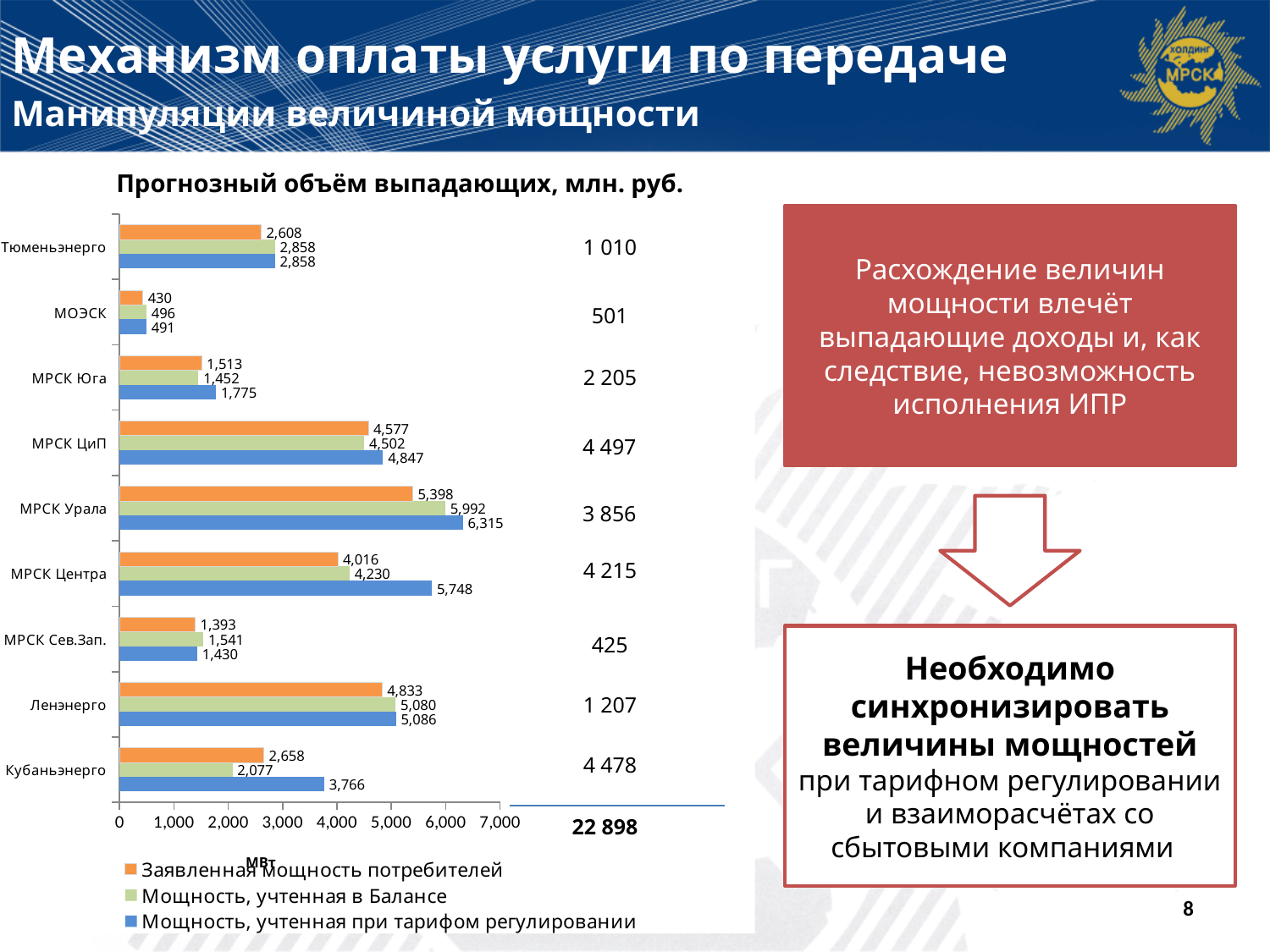
How many categories (companies) are shown on the chart? 9 What is the value of 'Мощность, учтенная при тарифом регулировании' for Кубаньэнерго? 3,766 How many series does the chart legend list? 3 What is the value of 'Заявленная мощность потребителей' for МРСК Урала? 5,398 Which category has the highest value for 'Мощность, учтенная при тарифом регулировании'? МРСК Урала For Кубаньэнерго, which is larger: 'Заявленная мощность потребителей' or 'Мощность, учтенная в Балансе'? Заявленная мощность потребителей What is the value of 'Мощность, учтенная в Балансе' for Ленэнерго? 5,080 What type of chart is shown on the slide? bar chart Which category has the lowest value for 'Заявленная мощность потребителей'? МОЭСК Which series is shown in blue in the chart legend? Мощность, учтенная при тарифом регулировании Is the value of 'Мощность, учтенная при тарифом регулировании' for МРСК Урала greater or less than 6,000? greater What is the difference between 'Мощность, учтенная при тарифом регулировании' and 'Заявленная мощность потребителей' for МРСК Центра? 1,732